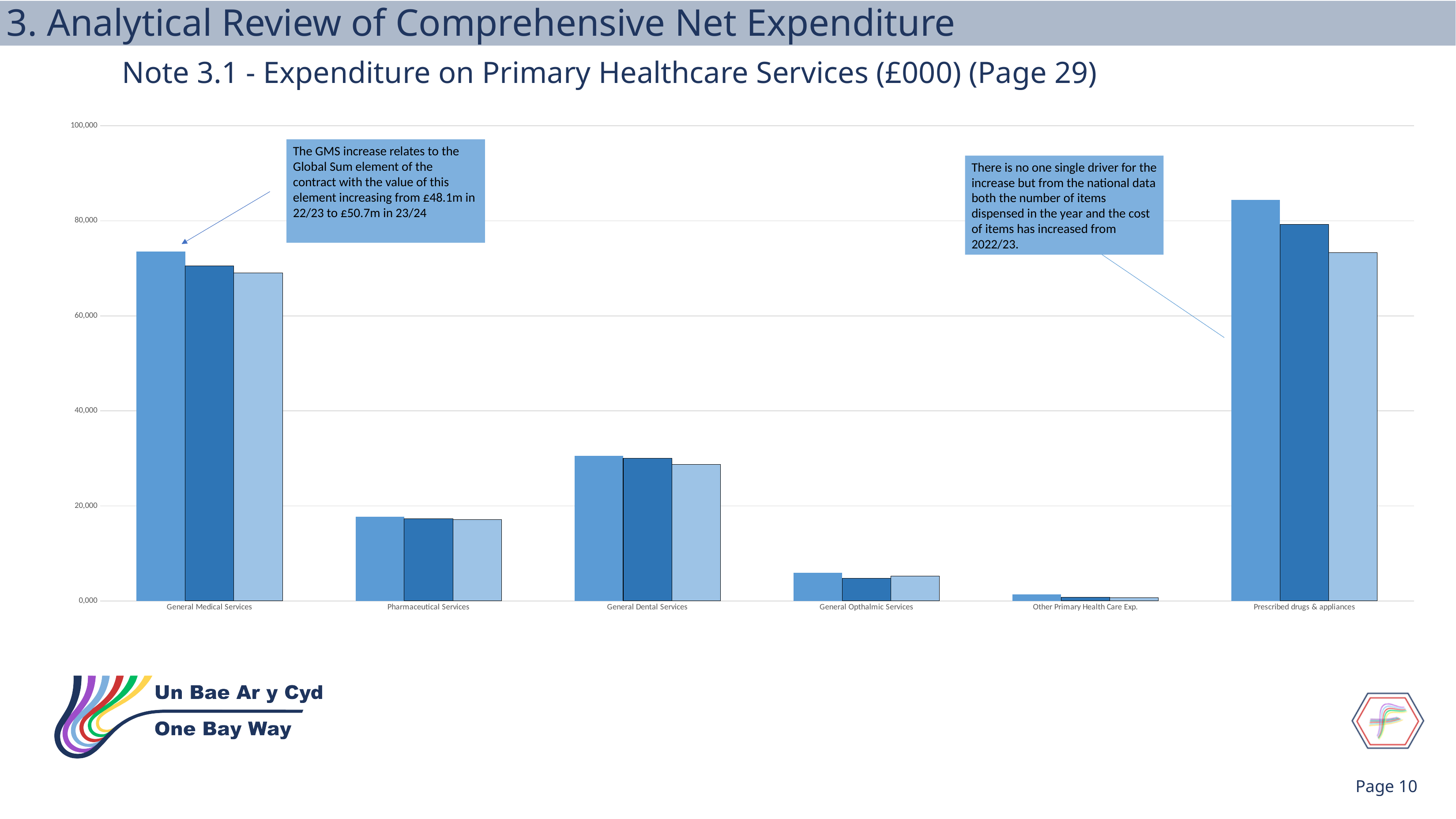
Which category has higher bars, General Medical Services or General Dental Services? General Medical Services Is the value of the tallest bar for Pharmaceutical Services greater or less than 20,000? less What kind of chart is shown on the slide? bar chart How many categories are shown on the x axis of the chart? 6 Is the value of the tallest bar for General Opthalmic Services greater or less than 20,000? less Is the value of the tallest bar for General Dental Services greater or less than 20,000? greater Which category has the shortest bars in the chart? Other Primary Health Care Exp. What is the title of the chart on the slide? Note 3.1 - Expenditure on Primary Healthcare Services (£000) (Page 29) Which category has higher bars, Pharmaceutical Services or General Opthalmic Services? Pharmaceutical Services Which category has the tallest bars in the chart? Prescribed drugs & appliances